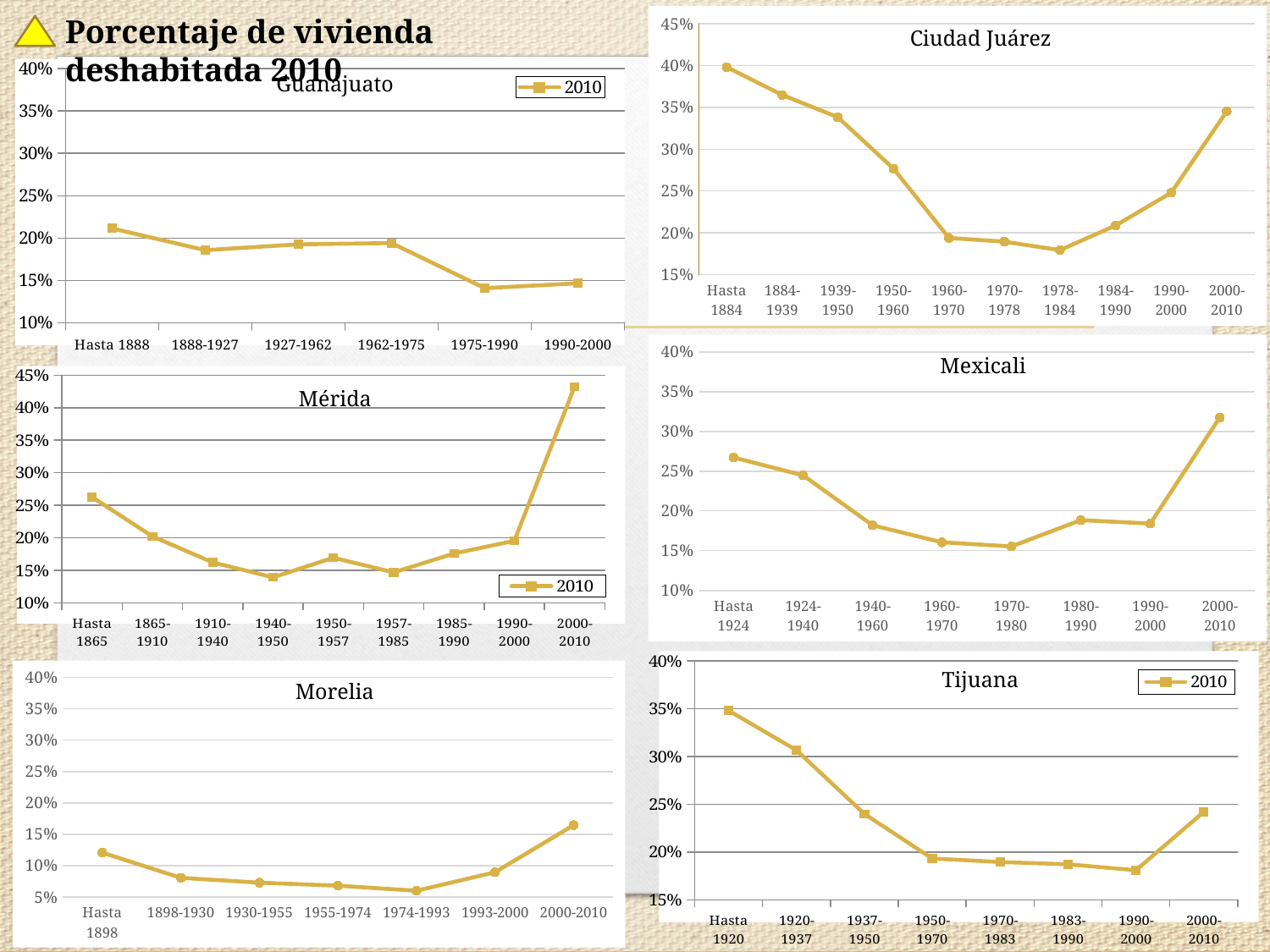
In the Morelia chart, is the value for Hasta 1898 greater or less than 10%? greater In the Guanajuato chart, is the value for 1975-1990 greater or less than 15%? less What entry does the legend of the Tijuana chart show? 2010 How many periods are plotted on the x axis of the Morelia chart? 7 How many periods are plotted on the x axis of the Ciudad Juárez chart? 10 What kind of chart is the Guanajuato chart? line chart In the Mérida chart, which period has the highest value? 2000-2010 In the Tijuana chart, do the values rise or fall from Hasta 1920 to 1950-1970? fall In the Ciudad Juárez chart, which period has the highest value? Hasta 1884 In the Mexicali chart, is the value for 2000-2010 greater or less than 30%? greater How many charts are shown on the slide? 6 In the Tijuana chart, which is larger, the value for Hasta 1920 or the value for 2000-2010? Hasta 1920